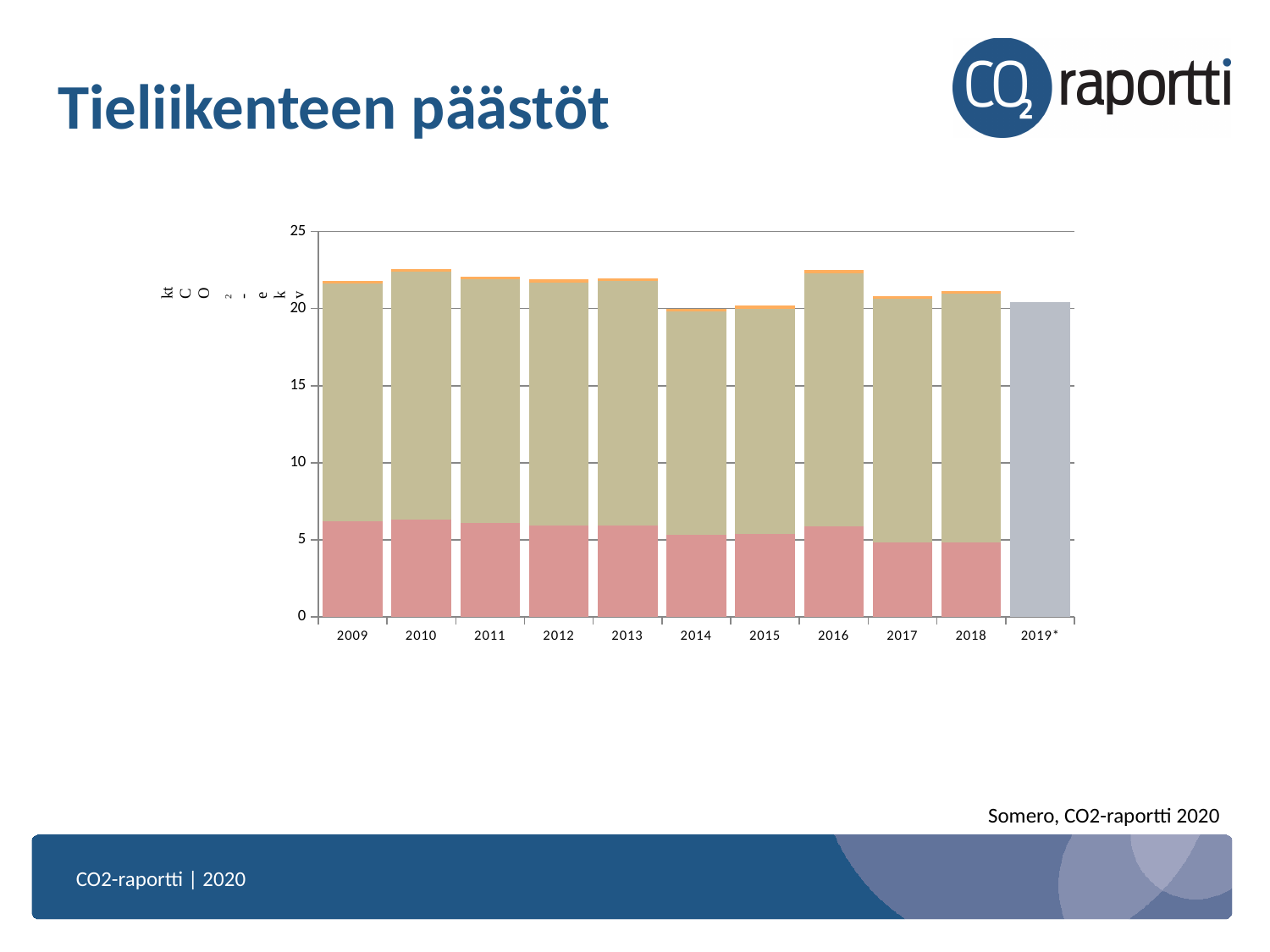
Which year has the larger total bar, 2016 or 2015? 2016 Is the total value for 2010 greater or less than 20? greater What is the title of the slide containing the chart? Tieliikenteen päästöt Do the total bar values rise or fall from 2010 to 2014? fall Which year has the larger bottom (pink) segment, 2010 or 2018? 2010 Which year's bar is drawn in a different (grey) colour from the others? 2019* How many years are shown on the x axis of the chart? 11 Is the bottom (pink) segment for 2014 greater or less than 10? less Is the bottom (pink) segment for 2009 greater or less than 5? greater What kind of chart is shown on the slide? bar chart Which year has the larger total bar, 2010 or 2014? 2010